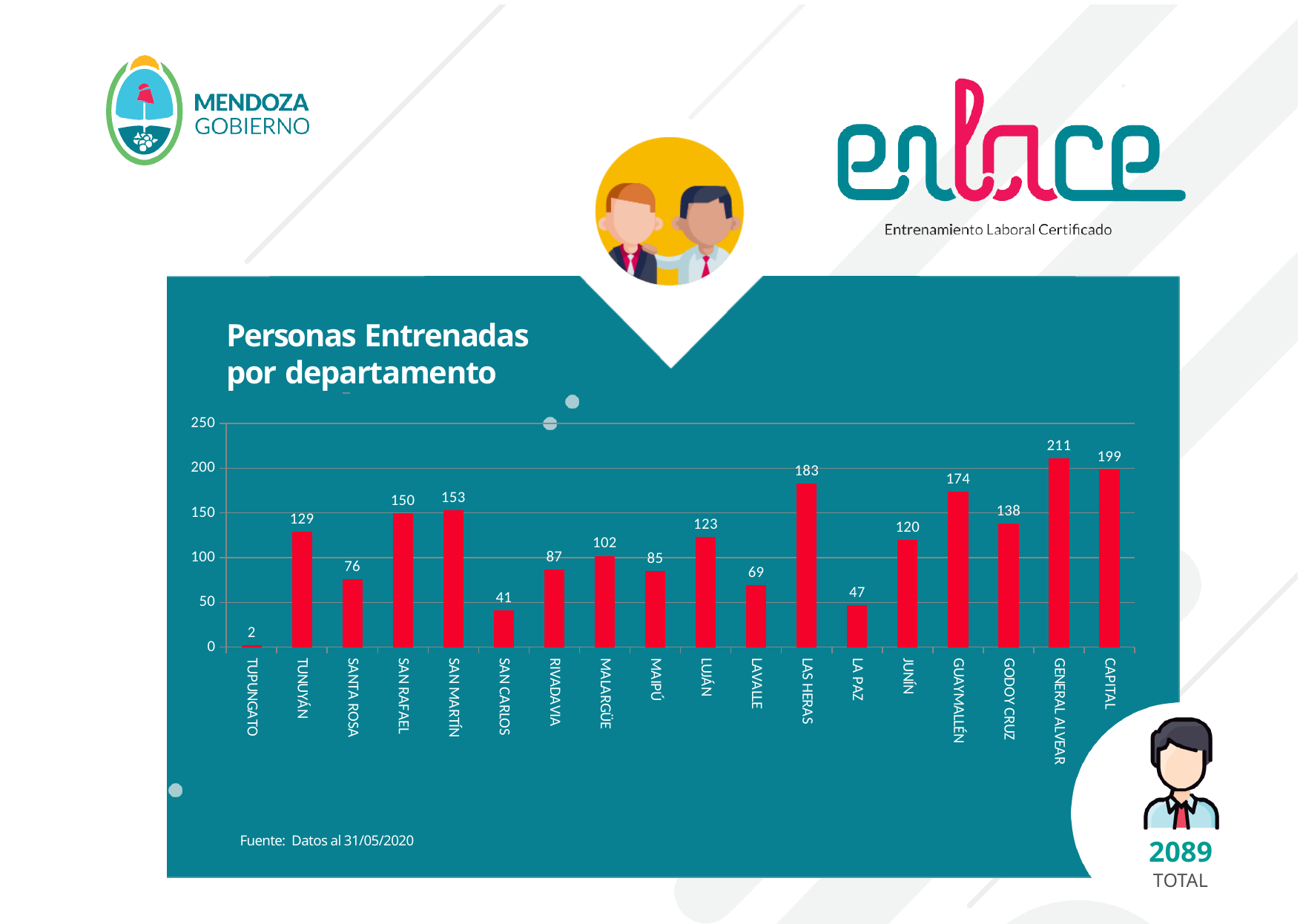
What type of chart is shown on the slide? Bar chart What is the difference between the values for General Alvear and Capital? 12 Which department has the lowest number of people trained? Tupungato How many people were trained in Las Heras according to the chart? 183 Which has a higher value, Lavalle or La Paz? Lavalle What is the difference between the values for Guaymallén and Godoy Cruz? 36 How many departments are shown in the chart? 18 What is the value shown for Malargüe? 102 Which has a higher value, San Rafael or San Martín? San Martín What is the title of the chart? Personas Entrenadas por departamento What is the value shown for Tupungato? 2 Which department has the highest number of people trained? General Alvear